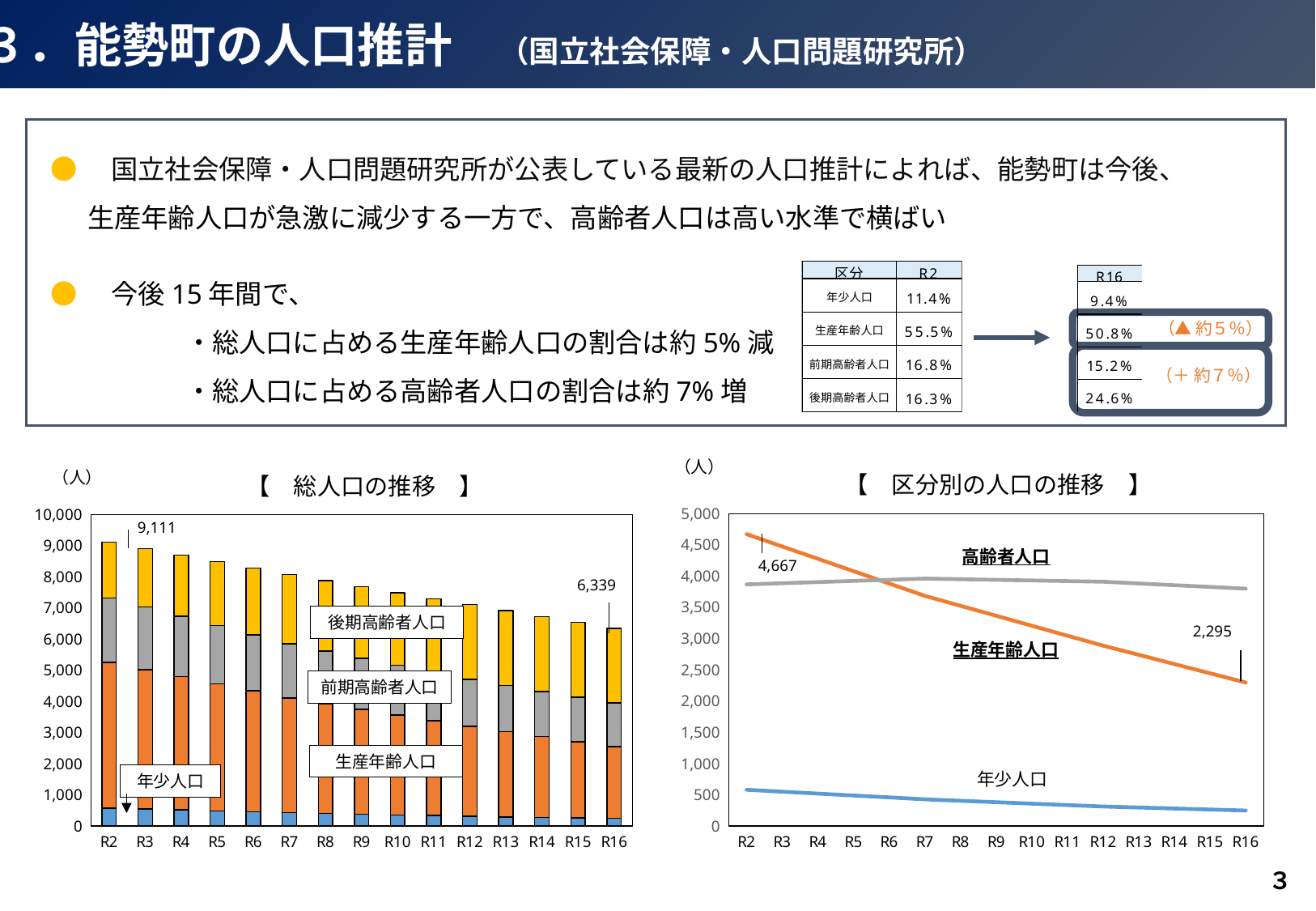
In the left chart 総人口の推移, what is the difference between the labelled totals for R2 and R16? 2,772 In the left chart 総人口の推移, what is the total population value labelled for R2? 9,111 In the right chart 区分別の人口の推移, what is the difference between the labelled 生産年齢人口 values at R2 and R16? 2,372 What kind of chart is the right chart titled 区分別の人口の推移? line chart What kind of chart is the left chart titled 総人口の推移? bar chart In the left chart 総人口の推移, do the total bar heights rise or fall from R2 to R16? fall In the left chart 総人口の推移, what is the total population value labelled for R16? 6,339 In the left chart 総人口の推移, how many population categories are stacked in each bar? 4 In the right chart 区分別の人口の推移, what is the value labelled for 生産年齢人口 at R2? 4,667 In the right chart 区分別の人口の推移, what is the value labelled for 生産年齢人口 at R16? 2,295 In the left chart 総人口の推移, how many years are shown on the x axis? 15 In the right chart 区分別の人口の推移, at R16 which is larger, 高齢者人口 or 生産年齢人口? 高齢者人口